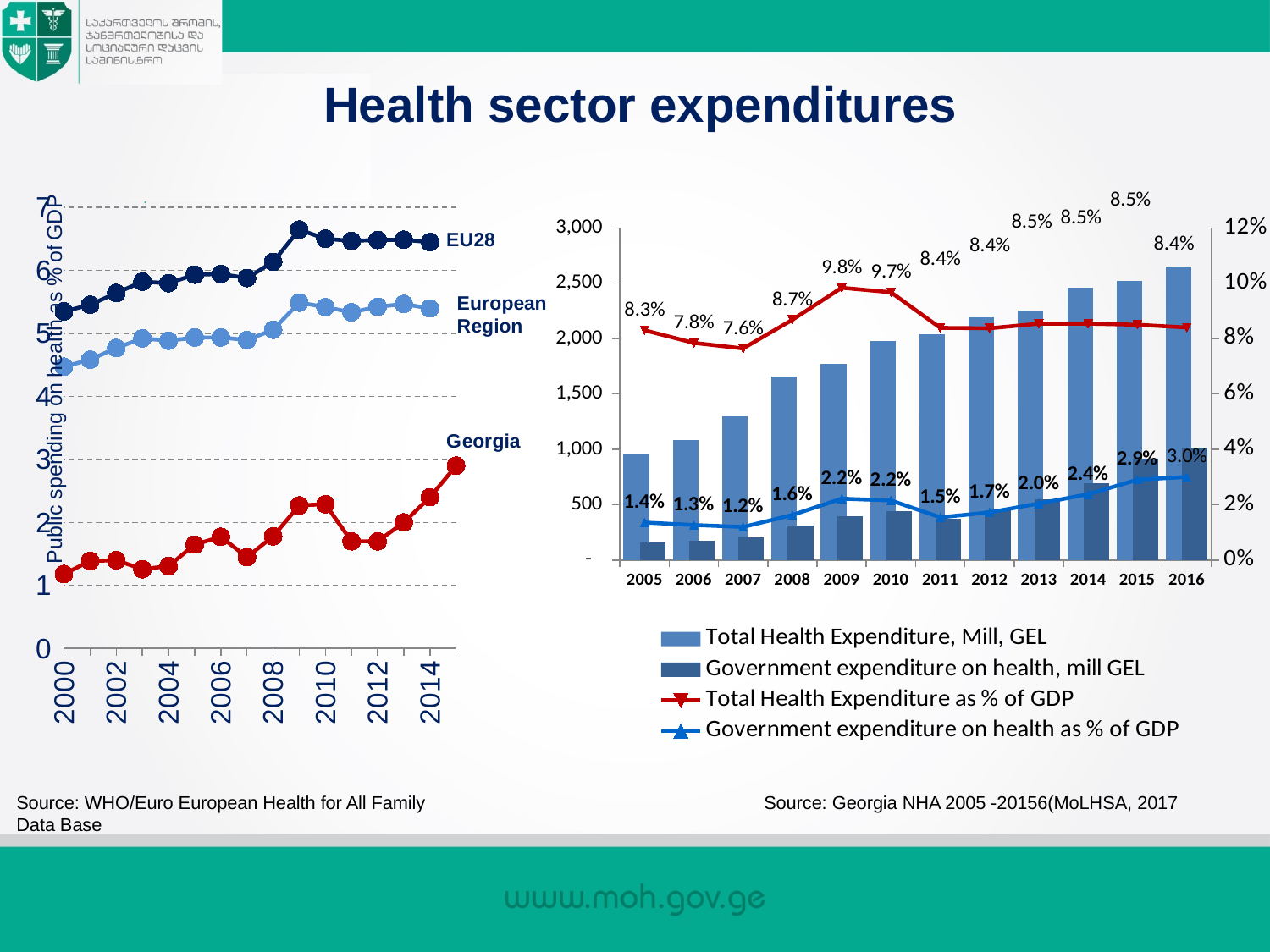
On the right chart, how many years are shown on the x axis? 12 On the right chart, what is the Total Health Expenditure as % of GDP in 2009? 9.8% On the right chart, is Government expenditure on health as % of GDP higher in 2014 or in 2011? 2014 On the right chart, in which year is Total Health Expenditure as % of GDP the lowest? 2007 On the right chart, what is the Government expenditure on health as % of GDP in 2016? 3.0% On the right chart, in which year is Government expenditure on health as % of GDP the highest? 2016 How many series does the legend of the right chart list? 4 On the right chart, does Government expenditure on health as % of GDP rise or fall from 2011 to 2016? rise On the left chart, which series is the lowest across all years: EU28, European Region or Georgia? Georgia What kind of chart is the left chart showing public spending on health as % of GDP? line chart On the right chart, is the Total Health Expenditure in Mill GEL for 2016 greater or less than 2,500? greater On the right chart, what is the difference between Total Health Expenditure as % of GDP in 2009 and in 2007? 2.2%